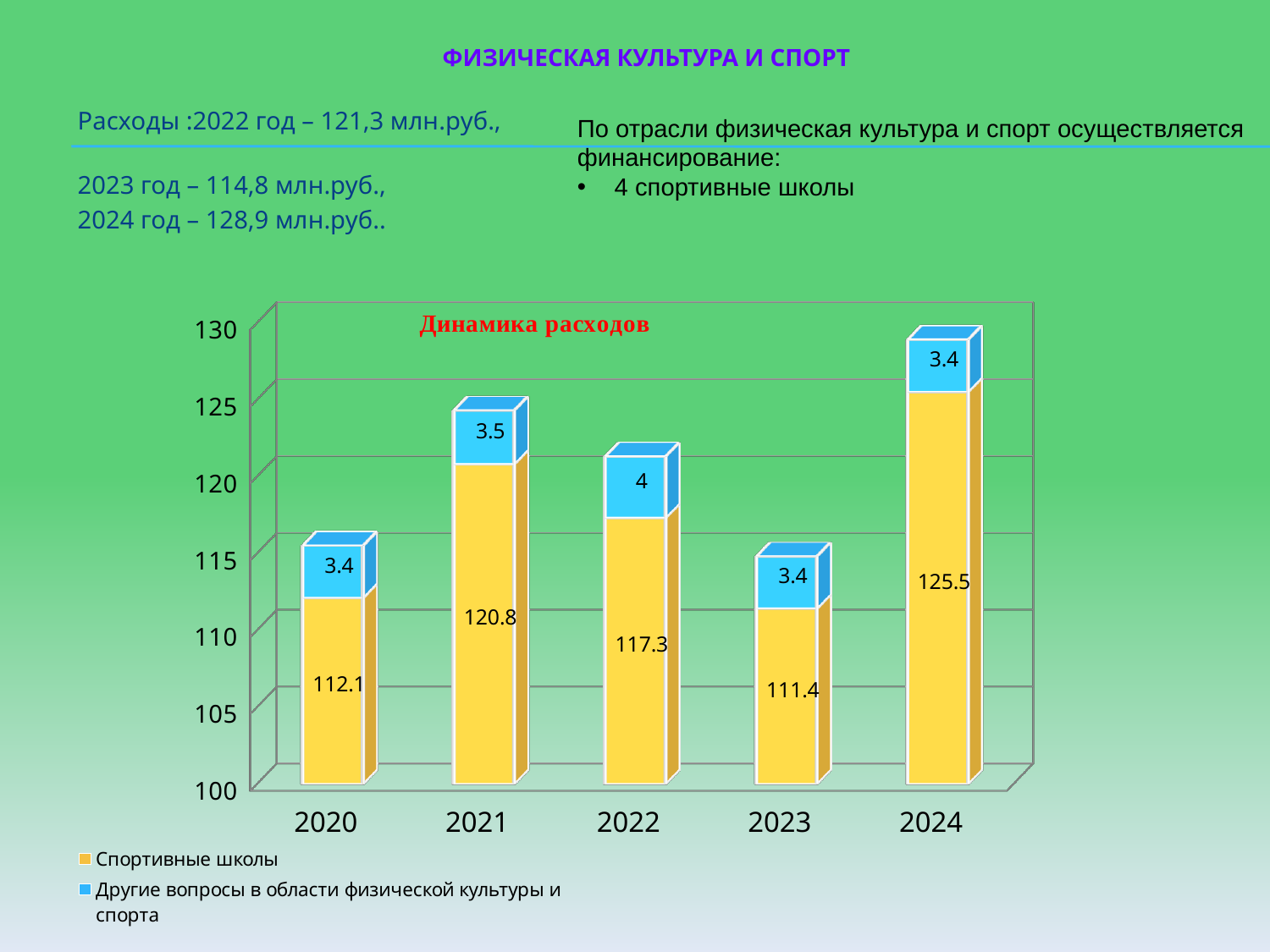
How many years are shown on the x axis? 5 What is the value for Другие вопросы в области физической культуры и спорта in 2022? 4 What is the difference between the Спортивные школы values for 2021 and 2020? 8.7 Which year has the lowest value for Спортивные школы? 2023 What is the total of the stacked bar for 2022? 121.3 What is the value for Спортивные школы in 2024? 125.5 What is the total of the stacked bar for 2024? 128.9 Which year has the highest value for Спортивные школы? 2024 What is the value for Спортивные школы in 2023? 111.4 What type of chart is shown on the slide? bar chart How many series does the legend list? 2 Which is larger, the Спортивные школы value for 2022 or for 2021? 2021